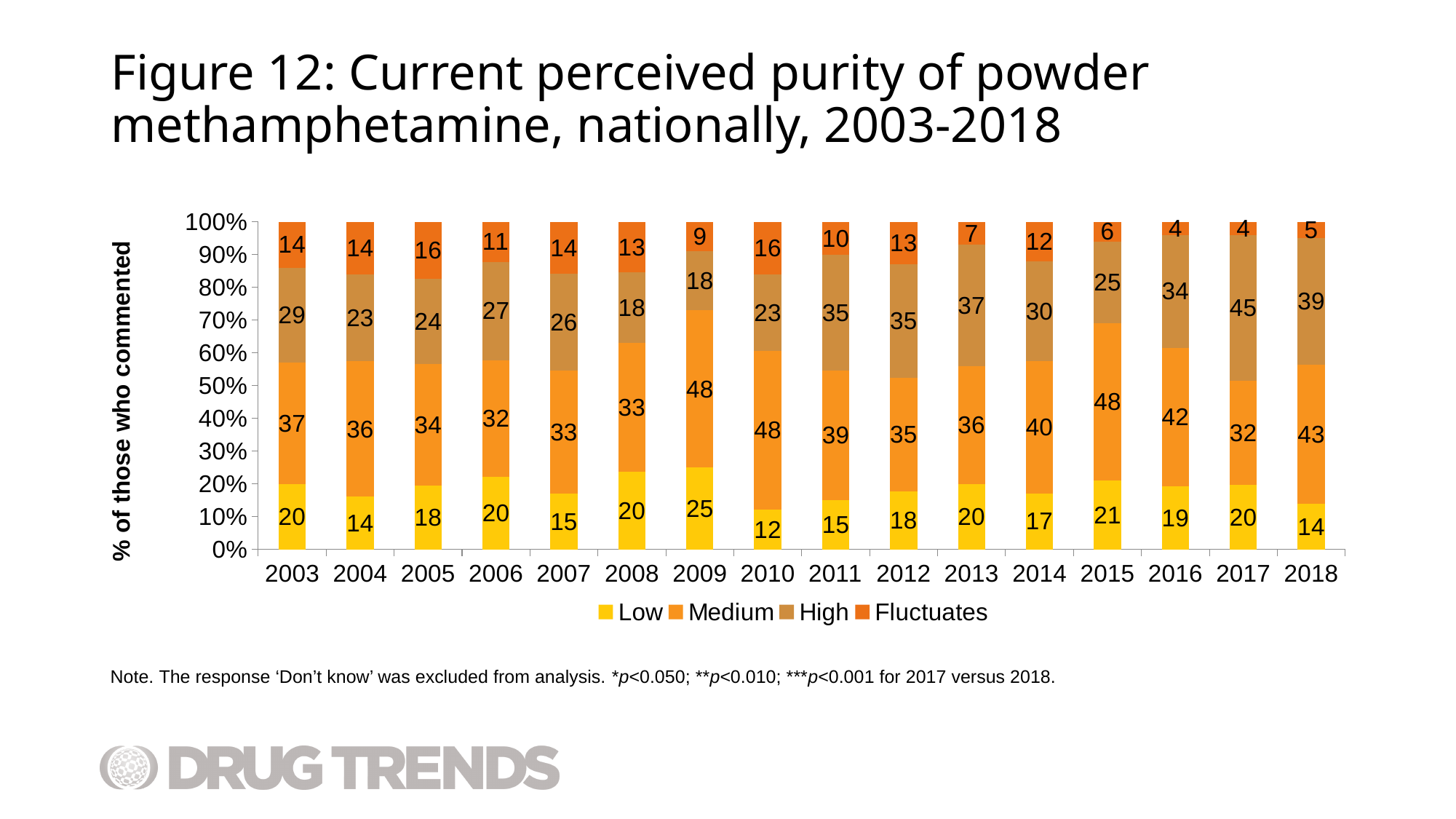
What is the value for Fluctuates in 2003? 14 In which year is the Low share highest? 2009 What is the value for High in 2017? 45 In which year is the High share highest? 2017 In 2018, which is larger: the Medium share or the Low share? Medium How many series does the legend list? 4 What is the value for Medium in 2015? 48 From 2015 to 2017, does the High share rise or fall? rise How many years are shown on the x axis? 16 What percentage of those who commented rated purity as Low in 2009? 25 What is the difference between the High value in 2017 and the High value in 2003? 16 In which year is the Low share lowest? 2010